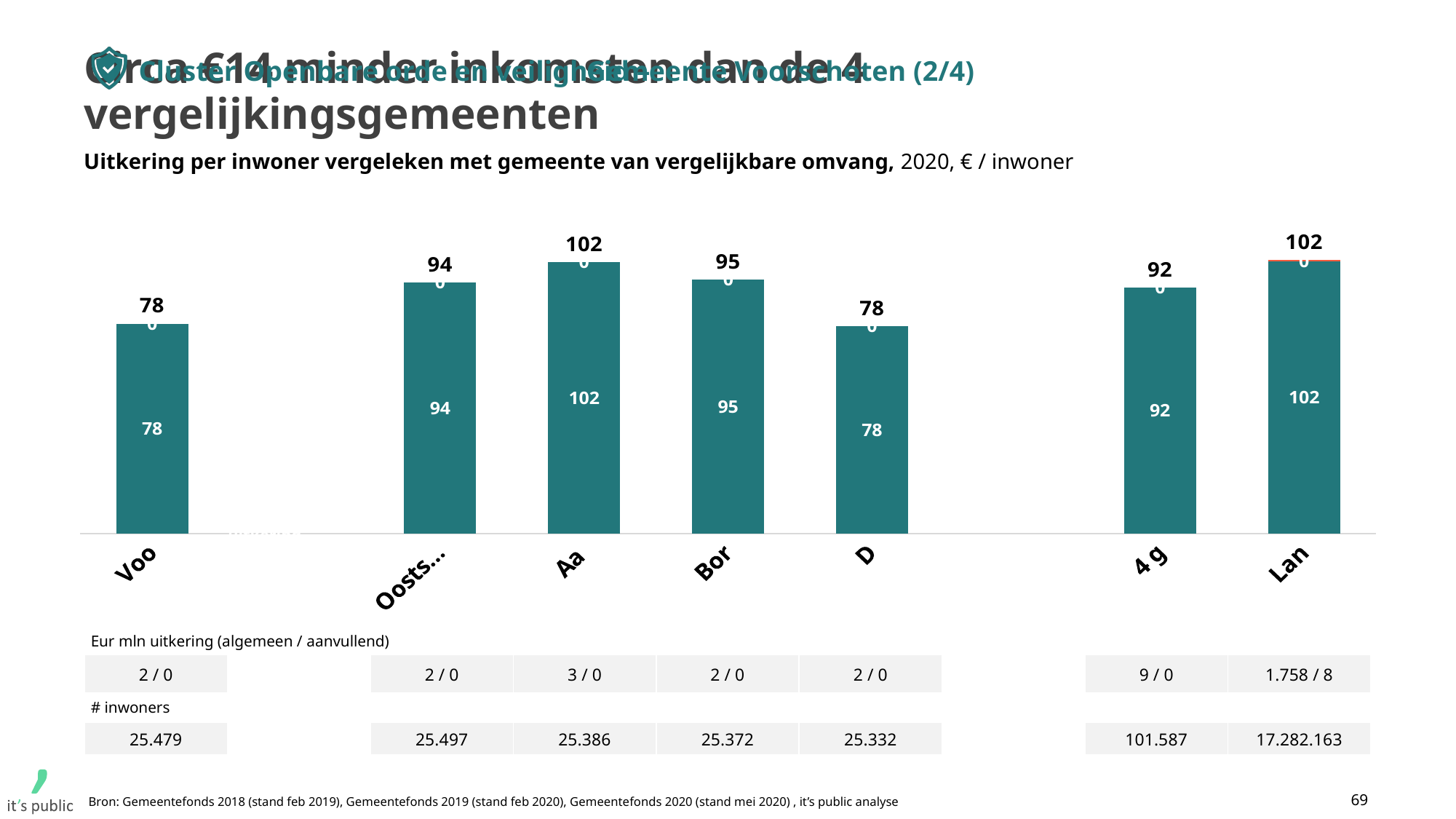
What is the difference between the values for Aa and Voo? 24 What is the value shown for the bar labelled Voo? 78 What is the difference between the values for Lan and 4 g? 10 How many bars are plotted in the chart? 7 Which has the larger value, Oosts... or D? Oosts... What kind of chart is shown on the slide? bar chart What is the highest value shown on any bar in the chart? 102 What is the value shown for the bar labelled Aa? 102 In what unit are the chart values expressed, according to the subtitle? € / inwoner What is the value shown for the bar labelled Bor? 95 What is the lowest value shown on any bar in the chart? 78 What is the value shown for the bar labelled 4 g? 92